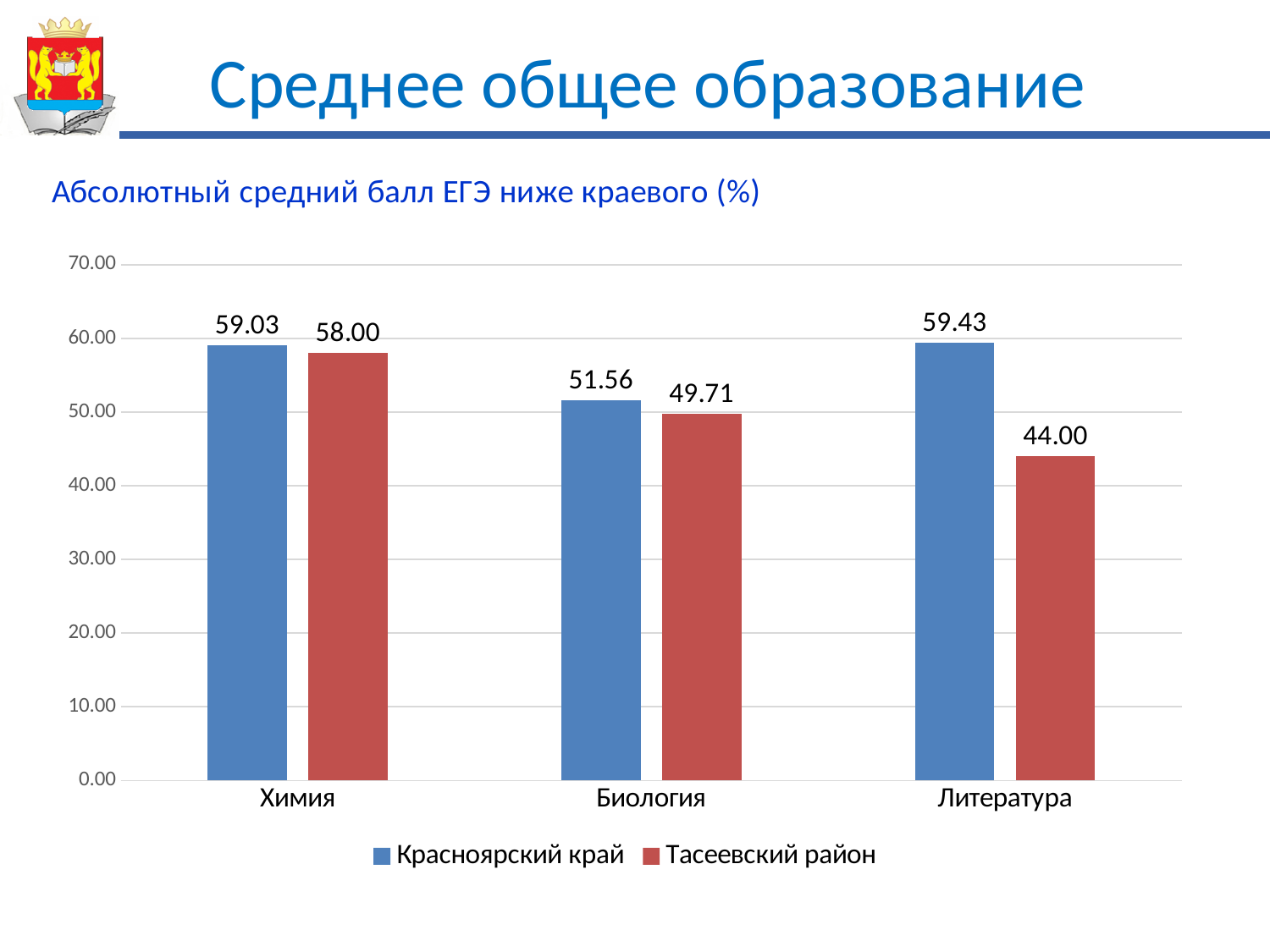
How many series does the legend list? 2 What is the difference between Красноярский край and Тасеевский район in Литература? 15.43 What is the value for Тасеевский район in Литература? 44.00 What is the value for Красноярский край in Химия? 59.03 What is the value for Тасеевский район in Биология? 49.71 Which colour represents Тасеевский район in the chart? Red What kind of chart is shown on the slide? Bar chart Which subject has the highest value for Красноярский край? Литература How many subjects are shown on the x axis? 3 Which is larger in Биология: Красноярский край or Тасеевский район? Красноярский край What is the difference between Красноярский край and Тасеевский район in Химия? 1.03 Which subject has the lowest value for Тасеевский район? Литература